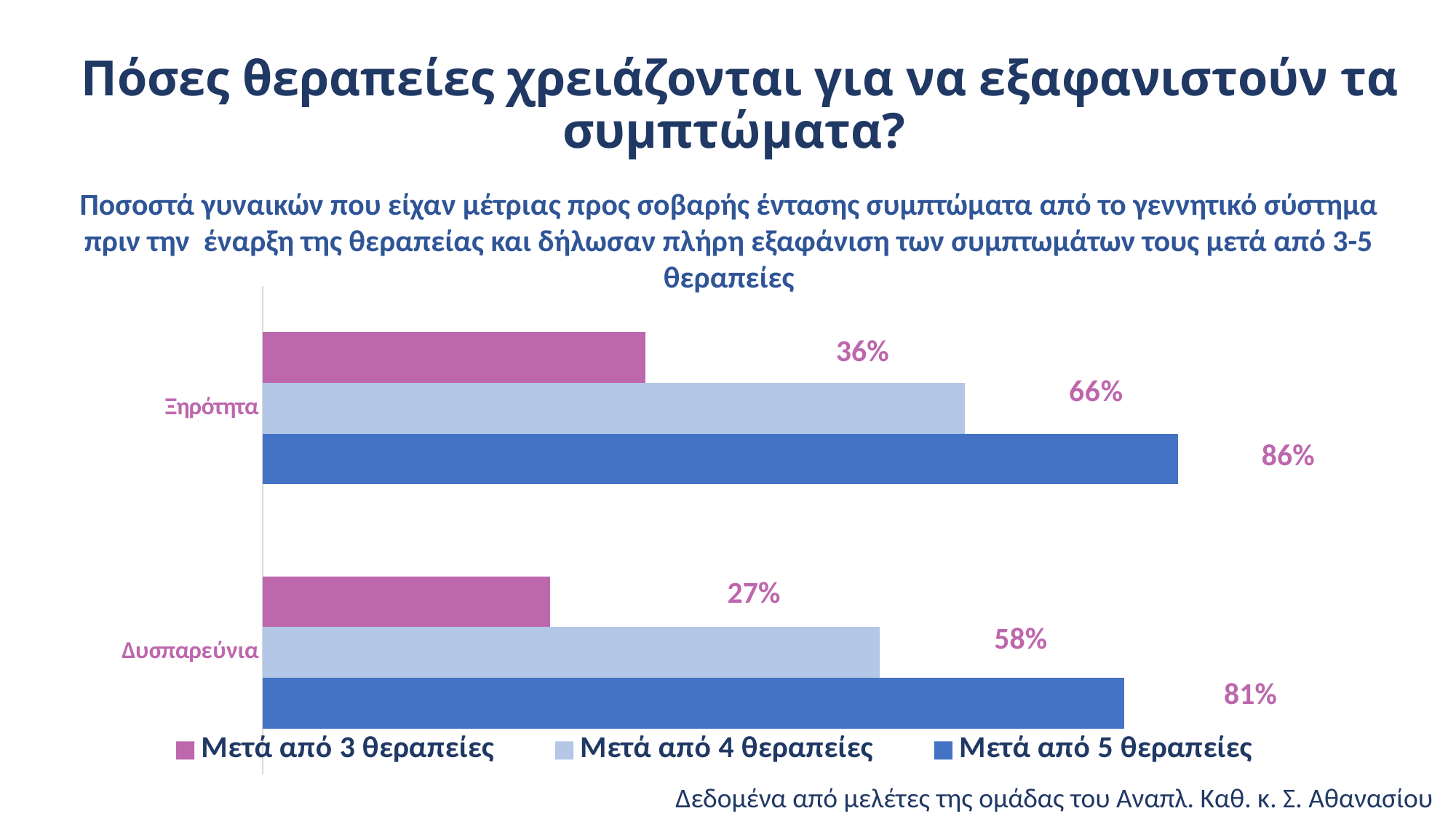
How many categories are shown on the chart? 2 What is the difference between the Ξηρότητα and Δυσπαρεύνια values after 4 treatments (Μετά από 4 θεραπείες)? 8% Which category has the lowest value after 3 treatments (Μετά από 3 θεραπείες)? Δυσπαρεύνια Which is larger: the Δυσπαρεύνια value after 4 treatments or the Ξηρότητα value after 3 treatments? Δυσπαρεύνια after 4 treatments What is the value for Ξηρότητα after 4 treatments (Μετά από 4 θεραπείες)? 66% What kind of chart is shown on the slide? Bar chart What is the value for Δυσπαρεύνια after 3 treatments (Μετά από 3 θεραπείες)? 27% How many series does the legend list? 3 What is the value for Δυσπαρεύνια after 5 treatments (Μετά από 5 θεραπείες)? 81% What is the value for Ξηρότητα after 3 treatments (Μετά από 3 θεραπείες)? 36% Which category has the highest value after 5 treatments (Μετά από 5 θεραπείες)? Ξηρότητα What is the difference between the values after 5 treatments and after 3 treatments for Ξηρότητα? 50%